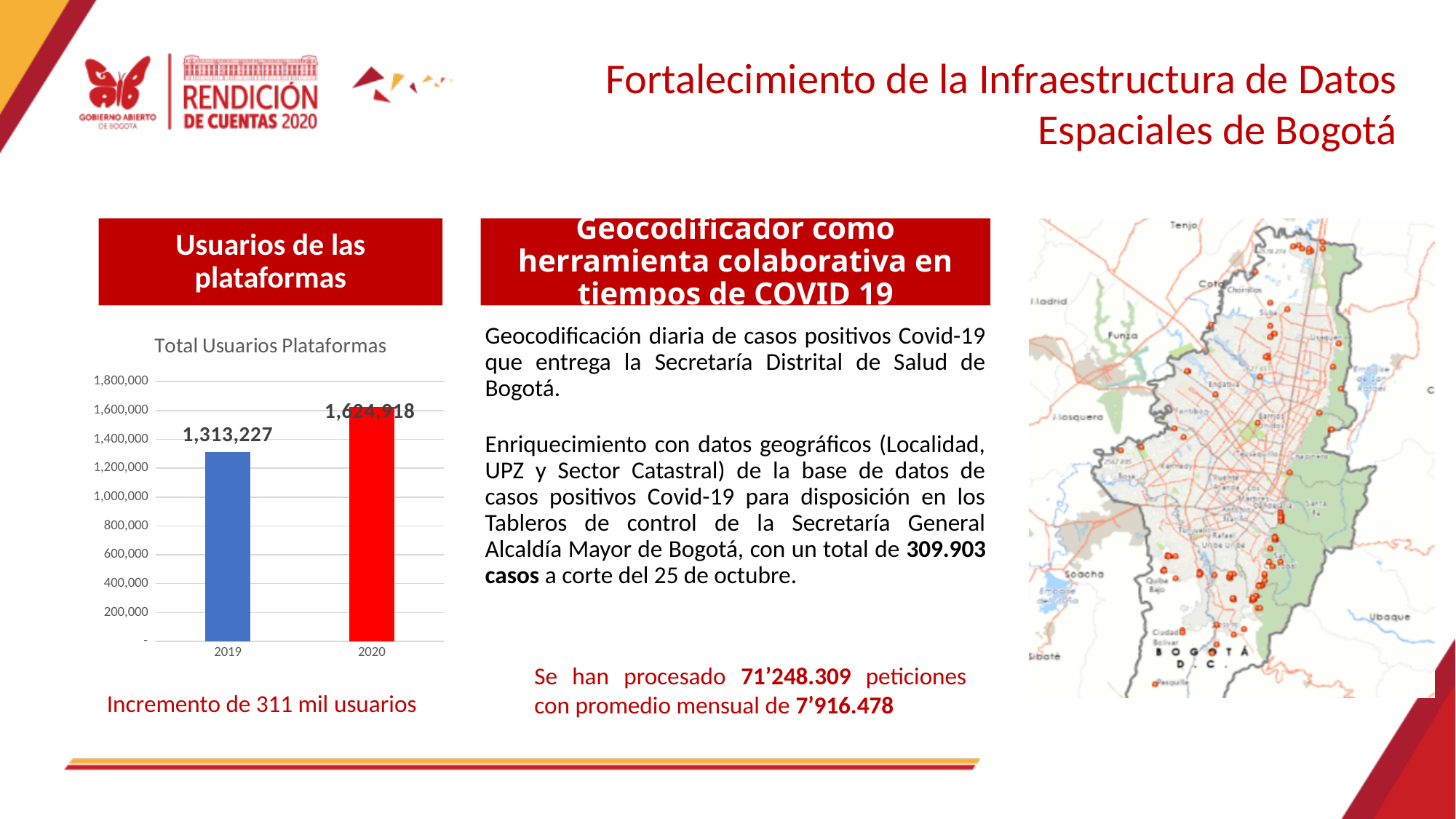
What is the title of the chart on the left of the slide? Total Usuarios Plataformas In the 'Total Usuarios Plataformas' chart, what is the value for 2020? 1,624,918 In the 'Total Usuarios Plataformas' chart, which year has the highest value? 2020 How many years are plotted in the 'Total Usuarios Plataformas' chart? 2 In the 'Total Usuarios Plataformas' chart, is the value for 2020 greater or less than 1,400,000? greater What kind of chart is shown under the heading 'Usuarios de las plataformas'? bar chart In the 'Total Usuarios Plataformas' chart, which is larger, the value for 2019 or the value for 2020? 2020 In the 'Total Usuarios Plataformas' chart, is the value for 2019 greater or less than 1,400,000? less In the 'Total Usuarios Plataformas' chart, what is the value for 2019? 1,313,227 In the 'Total Usuarios Plataformas' chart, which year has the lowest value? 2019 In the 'Total Usuarios Plataformas' chart, do the values rise or fall from 2019 to 2020? rise In the 'Total Usuarios Plataformas' chart, what colour is the bar for 2019? blue